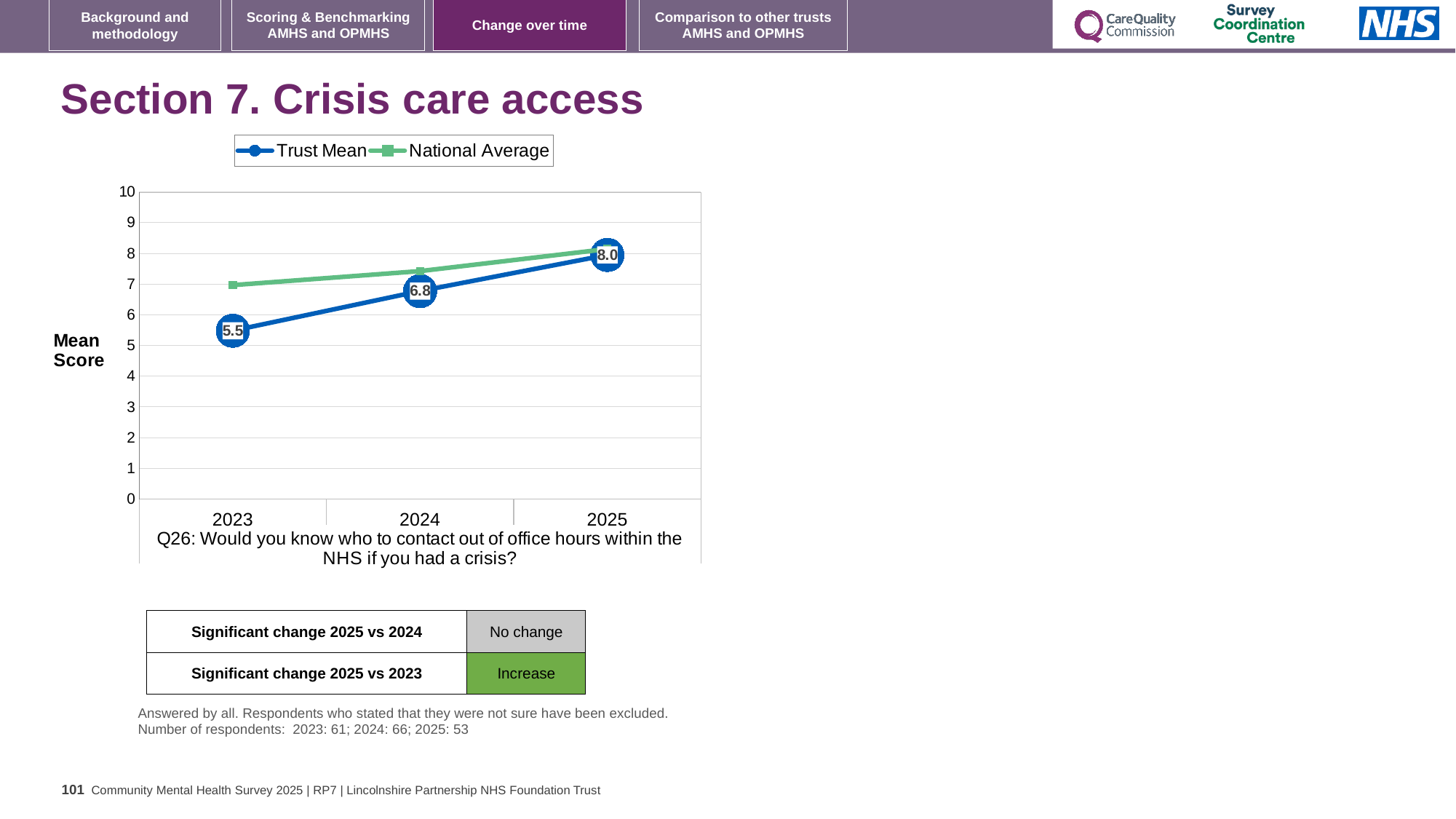
What is the difference between the Trust Mean score in 2024 and in 2023? 1.3 In 2023, which is larger: the Trust Mean or the National Average? National Average In which year is the Trust Mean score highest? 2025 What is the Trust Mean score for 2025? 8.0 Does the Trust Mean rise or fall from 2023 to 2025? rise Is the National Average value for 2024 greater or less than 7? greater What is the Trust Mean score for 2024? 6.8 How many series does the chart legend list? 2 In which year is the Trust Mean score lowest? 2023 What is the Trust Mean score for 2023? 5.5 How many years are shown on the x axis of the chart? 3 What is the difference between the Trust Mean score in 2025 and in 2023? 2.5